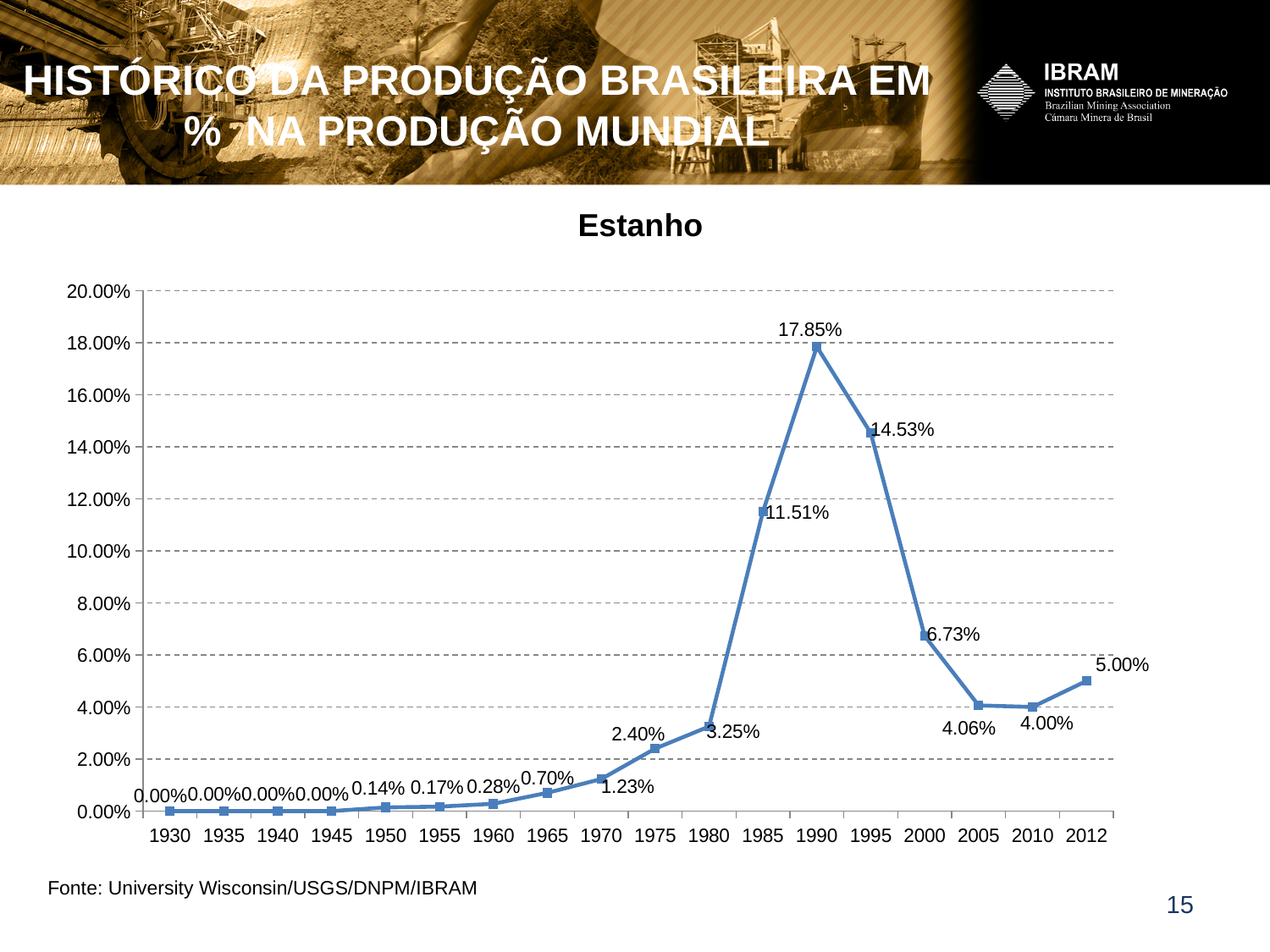
What is the value for 1990? 17.85% What is the difference between the values for 1990 and 1995? 3.32% Which is larger, the value for 2000 or the value for 2005? 2000 What type of chart is shown on the slide? line chart How many data points are plotted on the chart? 18 What is the value for 1965? 0.70% What is the value for 1985? 11.51% What is the value for 2012? 5.00% Is the value for 1995 greater or less than 14.00%? greater Which year has the highest value? 1990 What is the title of the chart? Estanho Do the values rise or fall between 1990 and 2010? fall